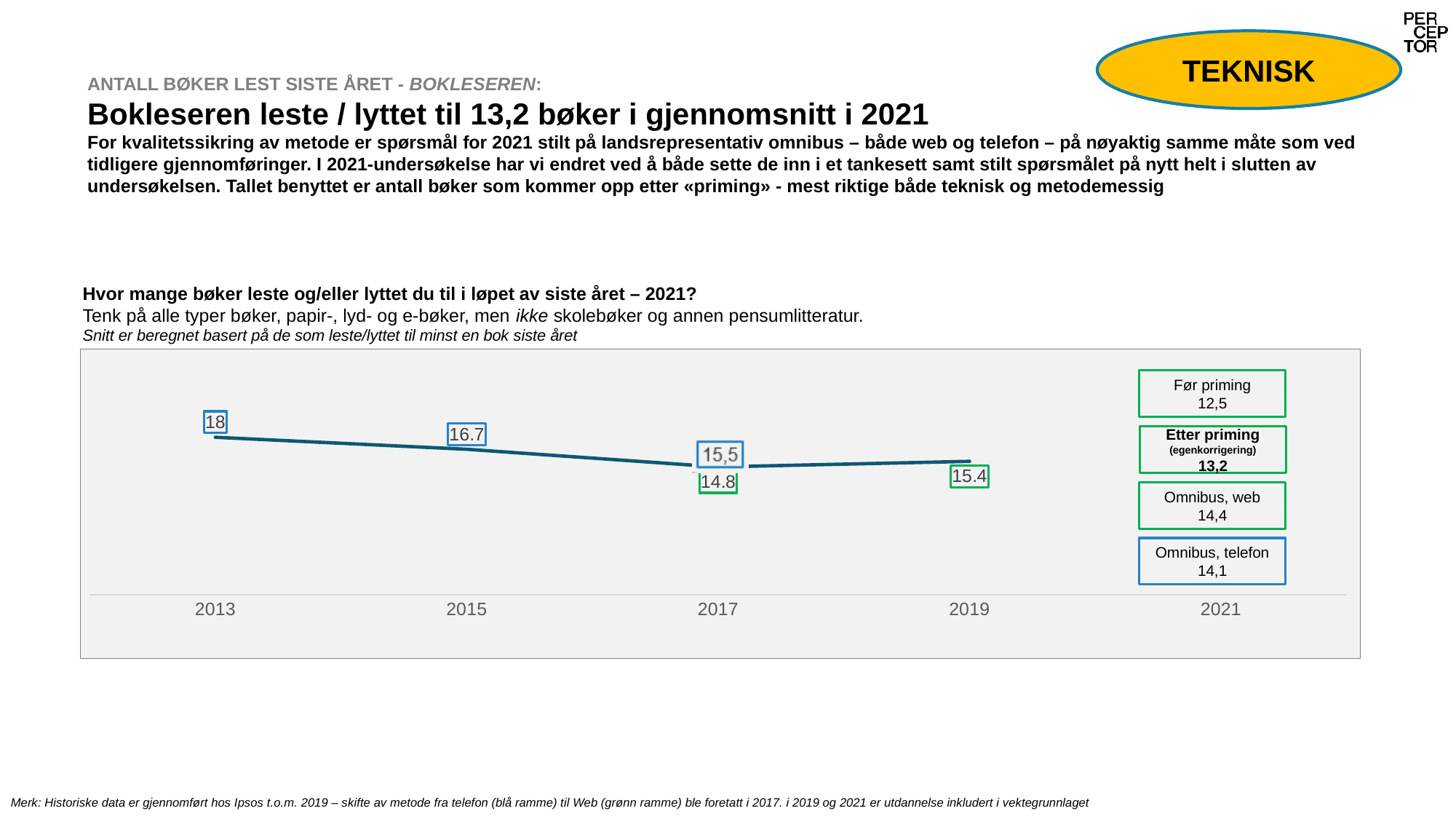
What value is shown for 2015 on the line chart? 16.7 What is the 'Omnibus, web' value shown for 2021? 14,4 How many years are labelled on the x axis of the chart? 5 What value is shown for 2019 on the line chart? 15.4 What is the value in the blue-framed label for 2017? 15,5 What is the difference between the values for 2013 and 2015? 1.3 What value is shown for 2013 on the line chart? 18 Do the values on the line chart rise or fall from 2013 to 2017? fall What kind of chart is shown on the slide? line chart Which year has the highest value on the line chart? 2013 Which is larger, the value for 2015 or the value for 2019? 2015 What is the value in the green-framed label for 2017? 14.8